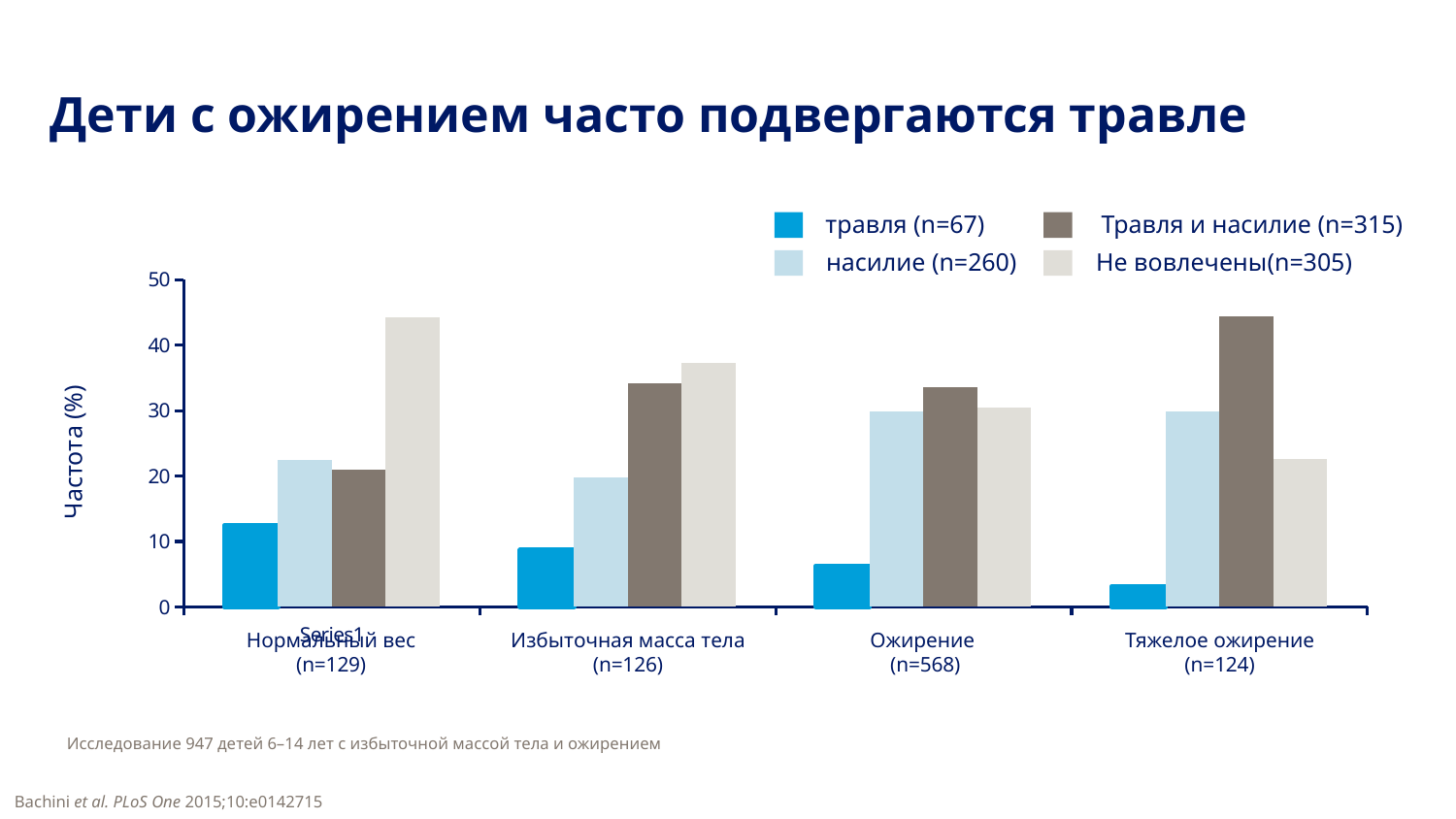
Which weight category has the highest value for Травля и насилие (n=315)? Тяжелое ожирение (n=124) How many weight categories are shown on the x axis of the chart? 4 Is the value for травля (n=67) in the Тяжелое ожирение (n=124) group greater or less than 10? less Which is larger: the Травля и насилие (n=315) value for Ожирение (n=568) or for Тяжелое ожирение (n=124)? Тяжелое ожирение (n=124) Does the value for травля (n=67) rise or fall moving from Нормальный вес to Тяжелое ожирение along the x axis? Fall How many series does the chart legend list? 4 Which weight category has the lowest value for травля (n=67)? Тяжелое ожирение (n=124) Which weight category has the highest value for Не вовлечены(n=305)? Нормальный вес (n=129) Is the value for Не вовлечены(n=305) in the Нормальный вес (n=129) group greater or less than 40? greater Is the value for Не вовлечены(n=305) in the Тяжелое ожирение (n=124) group greater or less than 30? less What kind of chart is shown on the slide? Bar chart